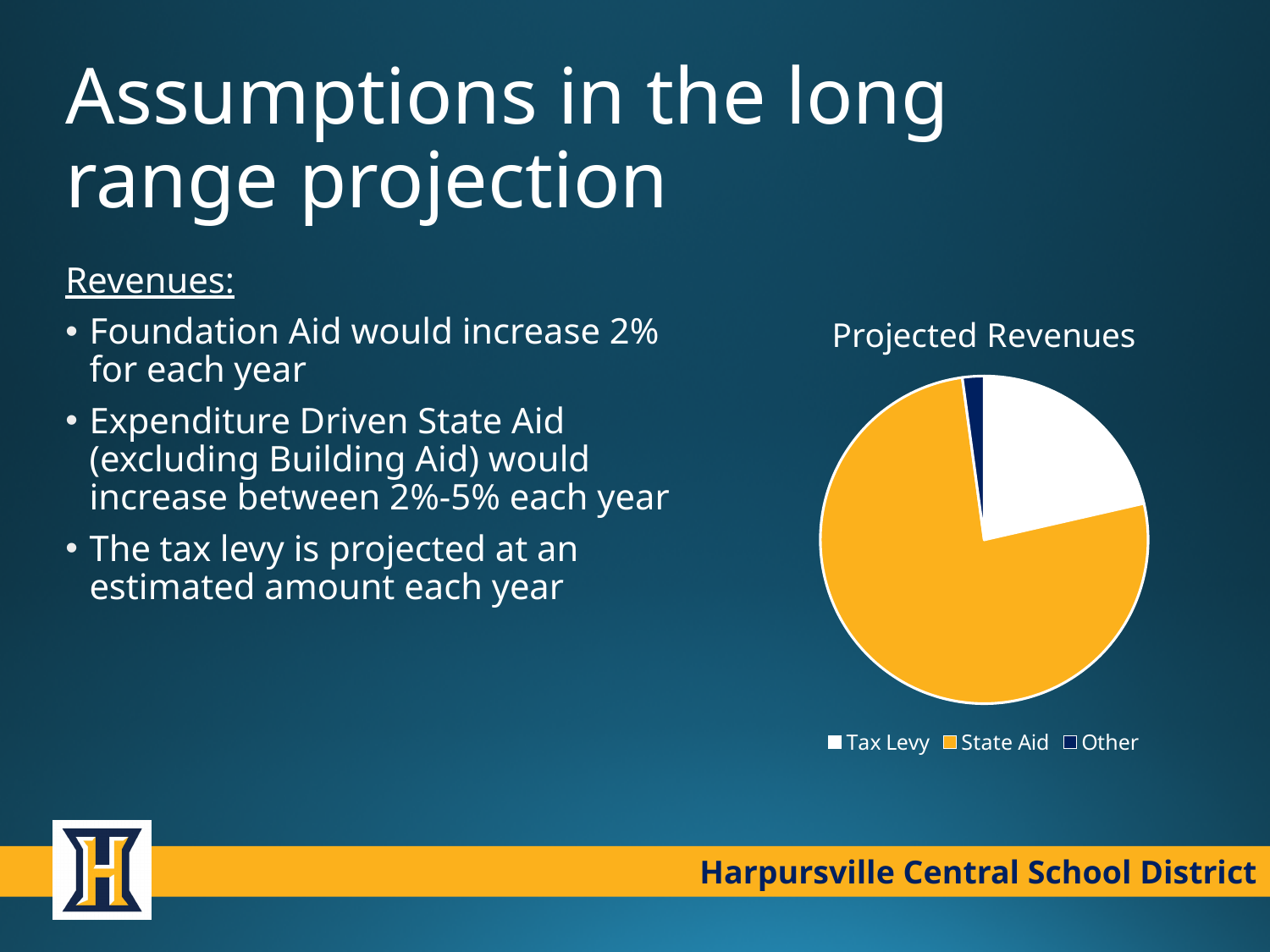
What is the title of the chart? Projected Revenues What type of chart is shown on the slide? Pie chart Does the State Aid slice make up more or less than half of the Projected Revenues pie? More What colour represents State Aid in the Projected Revenues pie chart? Orange How many entries does the legend of the Projected Revenues chart list? 3 Which category has the largest slice in the Projected Revenues pie chart? State Aid How many slices does the Projected Revenues pie chart have? 3 Which category has the smallest slice in the Projected Revenues pie chart? Tax Levy In the Projected Revenues pie chart, which slice is larger: State Aid or Other? State Aid In the Projected Revenues pie chart, which slice is larger: Other or Tax Levy? Other